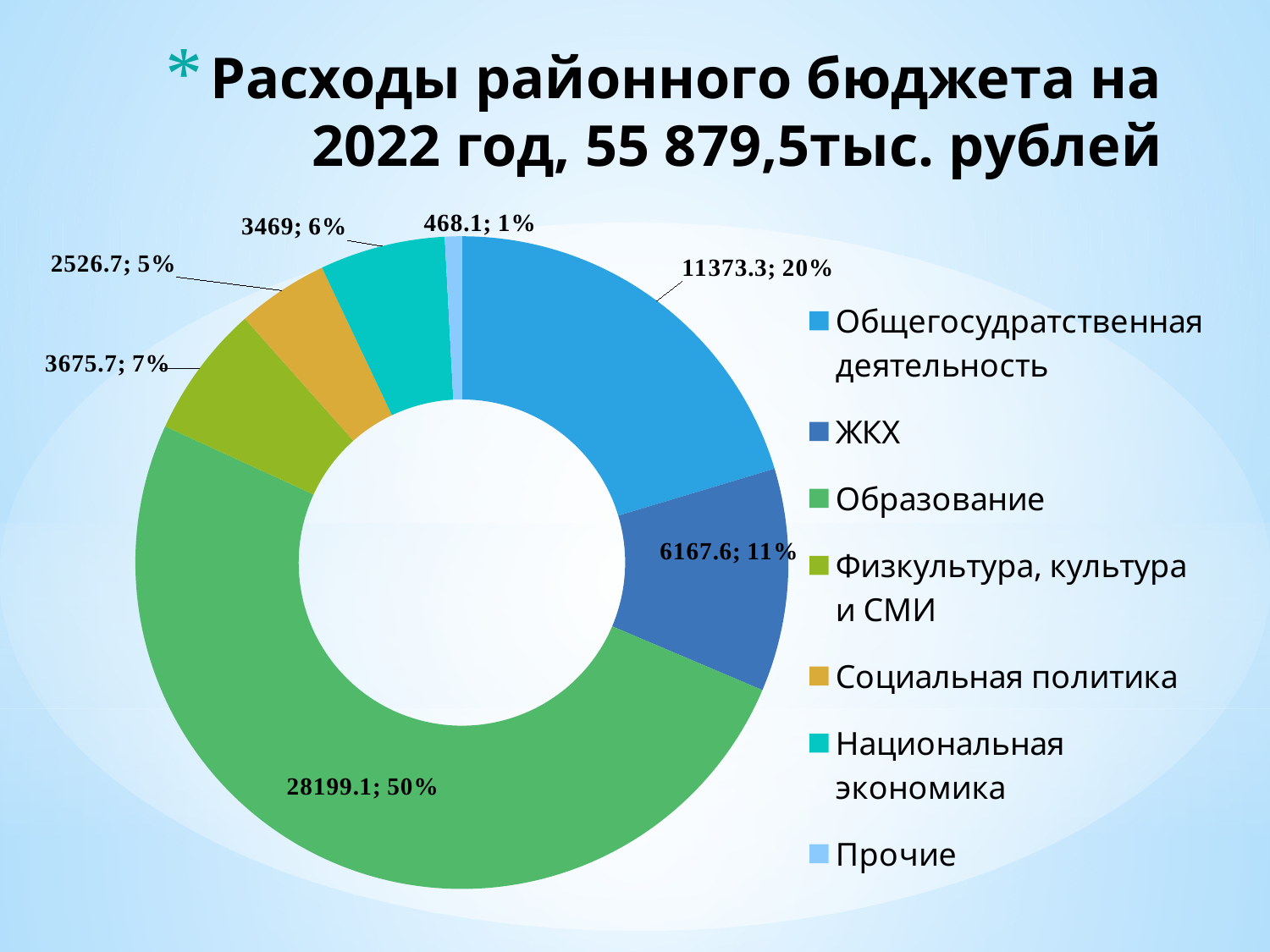
What is the difference between the values for Образование and Общегосудратственная деятельность? 16825.8 Which category has the largest slice? Образование What kind of chart is shown on the slide? pie chart (doughnut) What is the value for ЖКХ? 6167.6 What is the value for Образование? 28199.1 What share of the pie does Общегосудратственная деятельность take? 20% What share of the pie does Социальная политика take? 5% Which is larger, the value for Физкультура, культура и СМИ or the value for Социальная политика? Физкультура, культура и СМИ What is the value for Национальная экономика? 3469 How many categories does the legend list? 7 What is the value for Прочие? 468.1 Which category has the smallest slice? Прочие